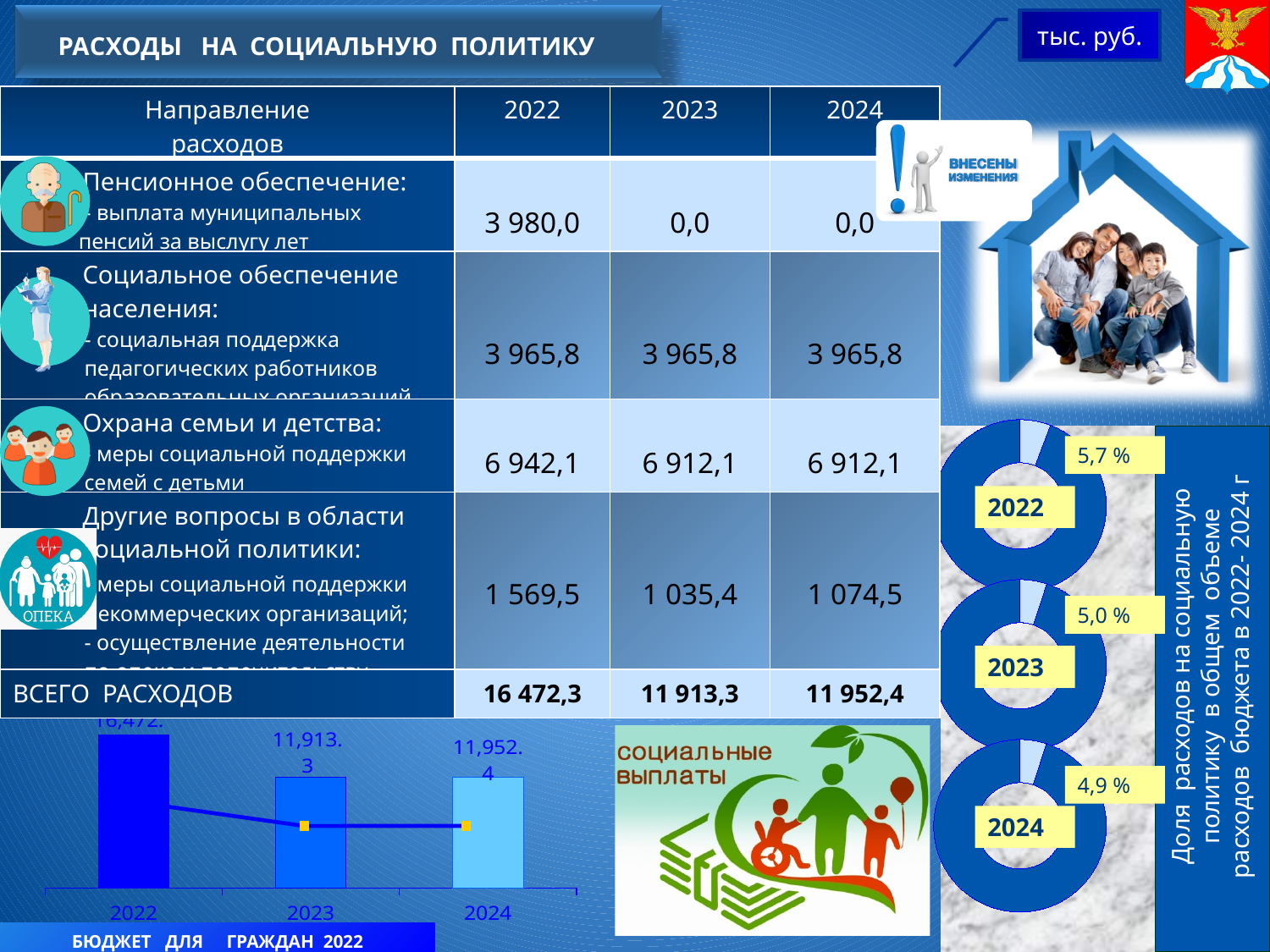
In the bar chart at the bottom left, what is the difference between the values for 2024 and 2023? 39.1 In the donut charts on the right, which year has the lowest share? 2024 In the donut charts on the right, what share is shown for 2024? 4,9 % In the bar chart at the bottom left, which year has the highest bar? 2022 In the bar chart at the bottom left, which year has the lowest bar? 2023 What type of chart is shown at the bottom left of the slide? bar chart In the bar chart at the bottom left, what is the value for 2024? 11,952.4 In the donut charts on the right, do the shares rise or fall from 2022 to 2024? fall In the bar chart at the bottom left, is the value for 2022 larger or smaller than the value for 2023? larger In the bar chart at the bottom left, what is the value for 2023? 11,913.3 How many bars are shown in the bar chart at the bottom left? 3 In the donut charts on the right, what share is shown for 2022? 5,7 %